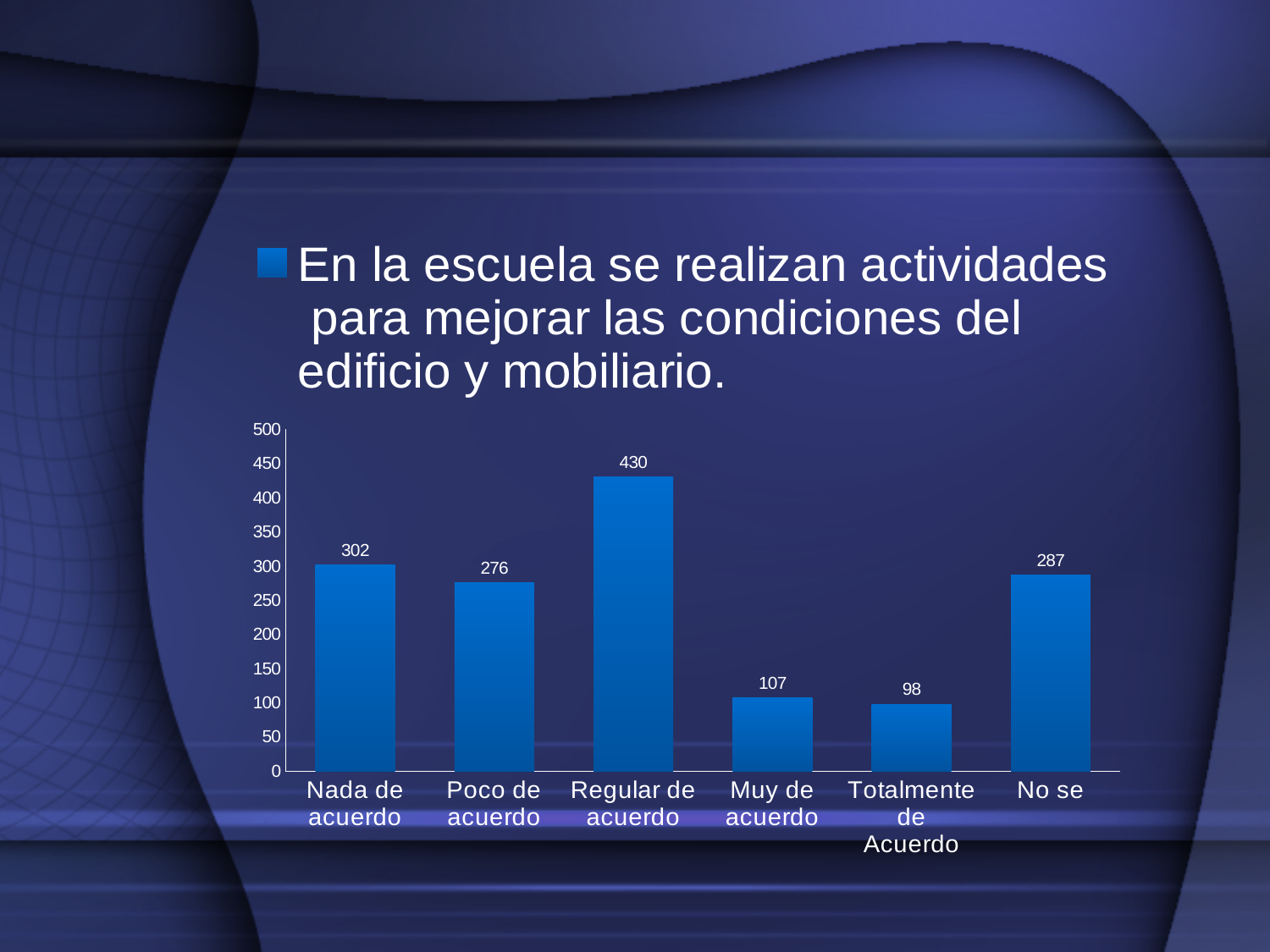
What is the difference between the values for "Regular de acuerdo" and "No se"? 143 What is the value for "No se"? 287 What is the value for "Regular de acuerdo"? 430 Is the value for "Poco de acuerdo" greater or less than 300? less What is the highest value shown on the y axis? 500 What kind of chart is shown on the slide? bar chart Which category has the highest value? Regular de acuerdo How many categories are shown on the x axis? 6 Which category has the lowest value? Totalmente de Acuerdo What is the difference between the values for "Nada de acuerdo" and "Poco de acuerdo"? 26 What is the value for "Totalmente de Acuerdo"? 98 Which is larger, the value for "Muy de acuerdo" or the value for "Totalmente de Acuerdo"? Muy de acuerdo